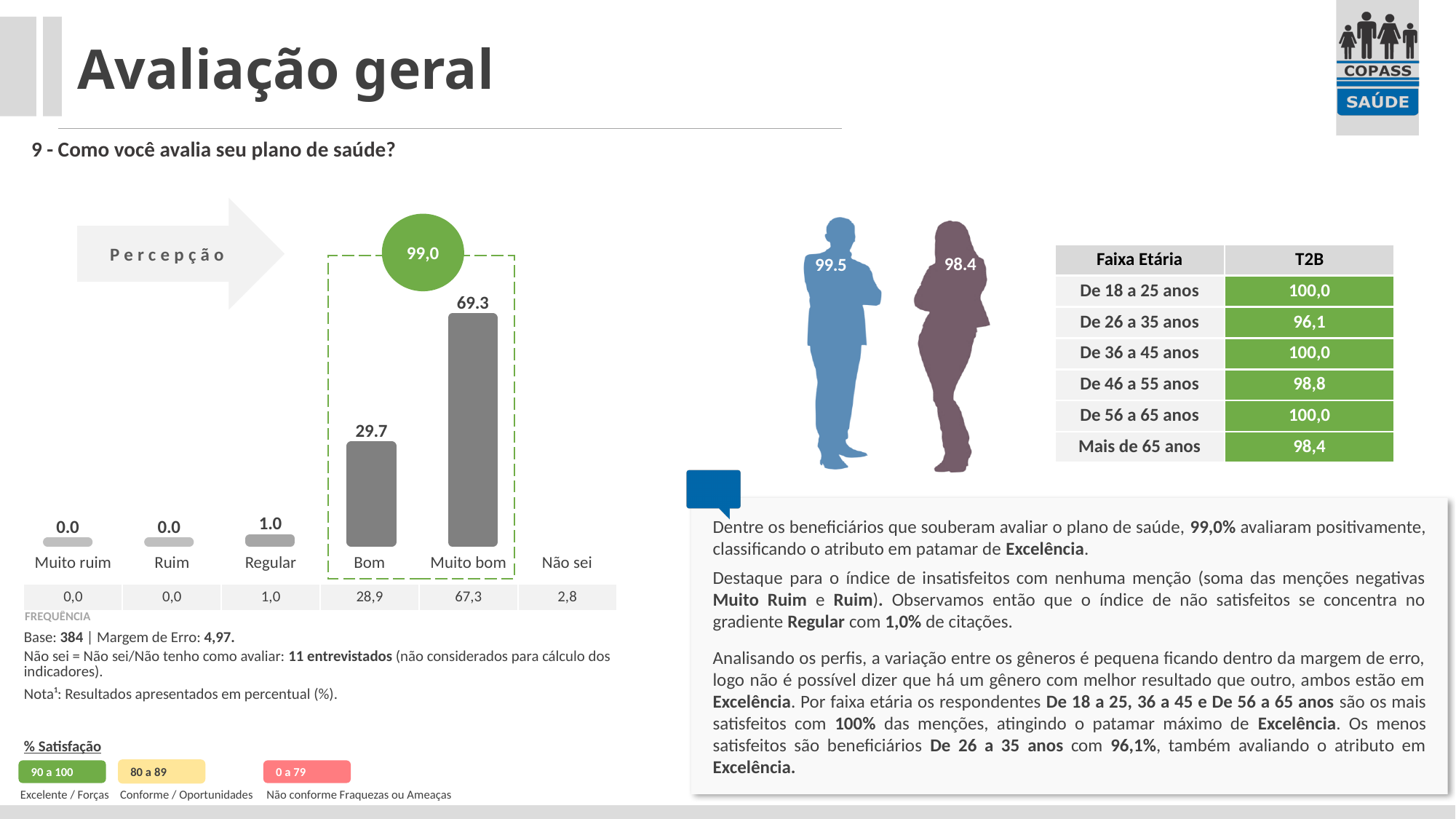
Which is larger in the bar chart, the value for 'Bom' or the value for 'Regular'? Bom In the bar chart, what is the value for 'Regular'? 1.0 In the 'Faixa Etária' table, which age group has the lowest T2B value? De 26 a 35 anos Which category has the highest value in the bar chart? Muito bom What is the difference between the values for 'Muito bom' and 'Bom' in the bar chart? 39.6 What is the combined value of 'Bom' and 'Muito bom' in the bar chart? 99.0 How many categories in the bar chart have a value of 0.0? 2 Do the bar values rise or fall going from 'Muito ruim' to 'Muito bom' along the x axis? rise In the bar chart, what is the value for 'Bom'? 29.7 What value is shown in the green circle above the bar chart? 99,0 In the bar chart, what is the value for 'Muito bom'? 69.3 What kind of chart is used to show the answers to 'Como você avalia seu plano de saúde?'? bar chart